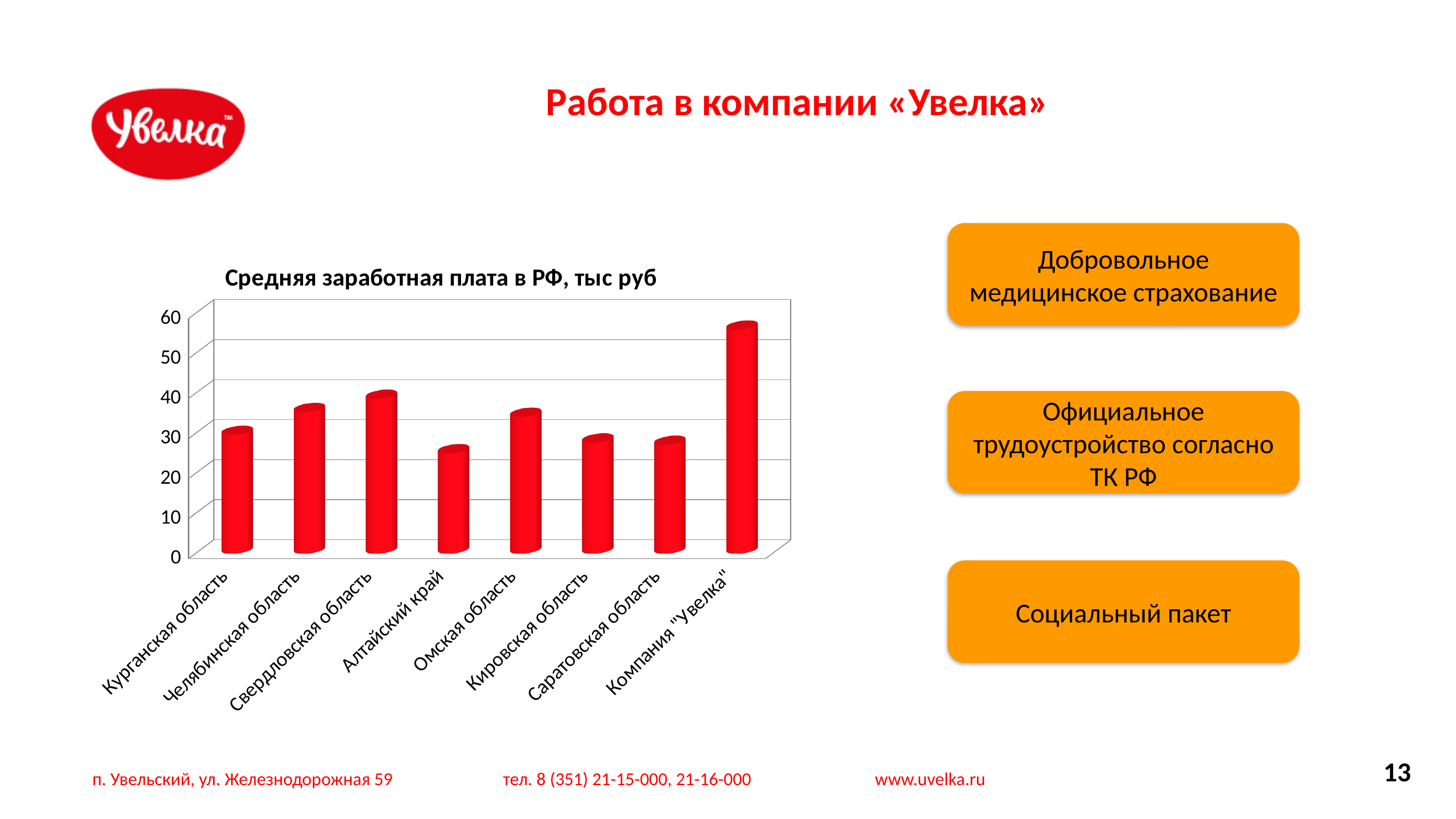
Which is larger, the value for Компания "Увелка" or the value for Свердловская область? Компания "Увелка" Is the value for Свердловская область greater or less than 30? greater Which is larger, the value for Челябинская область or the value for Саратовская область? Челябинская область Is the value for Алтайский край greater or less than 30? less Which category has the lowest bar in the chart? Алтайский край What kind of chart is shown on the slide? bar chart Which category has the highest bar in the chart? Компания "Увелка" Is the value for Компания "Увелка" greater or less than 50? greater How many categories are shown on the x axis of the chart? 8 Which is larger, the value for Свердловская область or the value for Челябинская область? Свердловская область What is the title of the chart? Средняя заработная плата в РФ, тыс руб